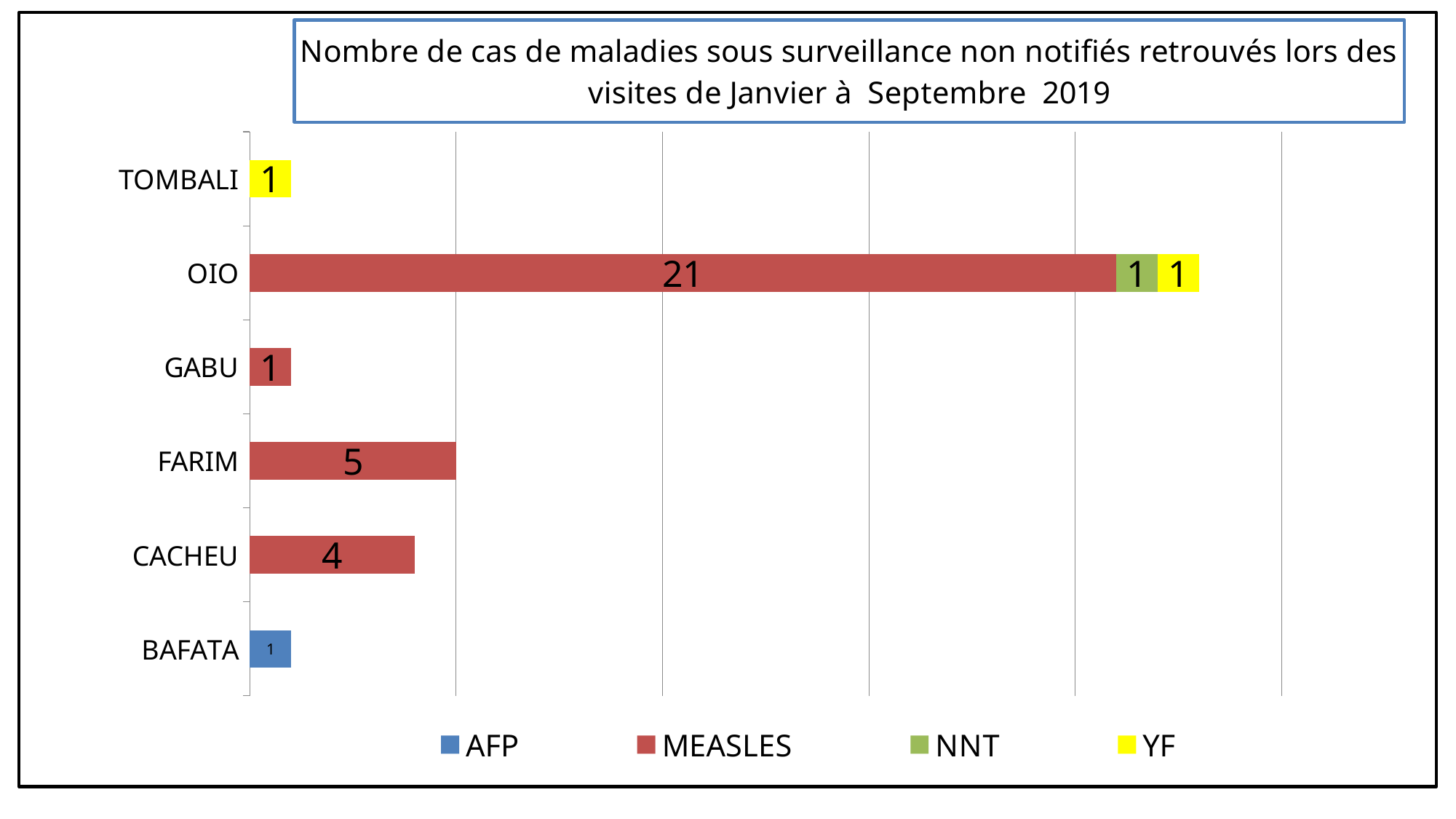
What is the MEASLES value for FARIM? 5 Which region has the highest MEASLES value? OIO What is the MEASLES value for OIO? 21 How many series does the legend list? 4 How many regions (categories) are shown on the chart? 6 What is the MEASLES value for CACHEU? 4 What type of chart is shown on the slide? bar chart What is the total of the stacked bar for OIO? 23 What is the YF value for TOMBALI? 1 Which series is shown in yellow in the legend? YF What is the difference between the MEASLES values for FARIM and CACHEU? 1 What is the AFP value for BAFATA? 1